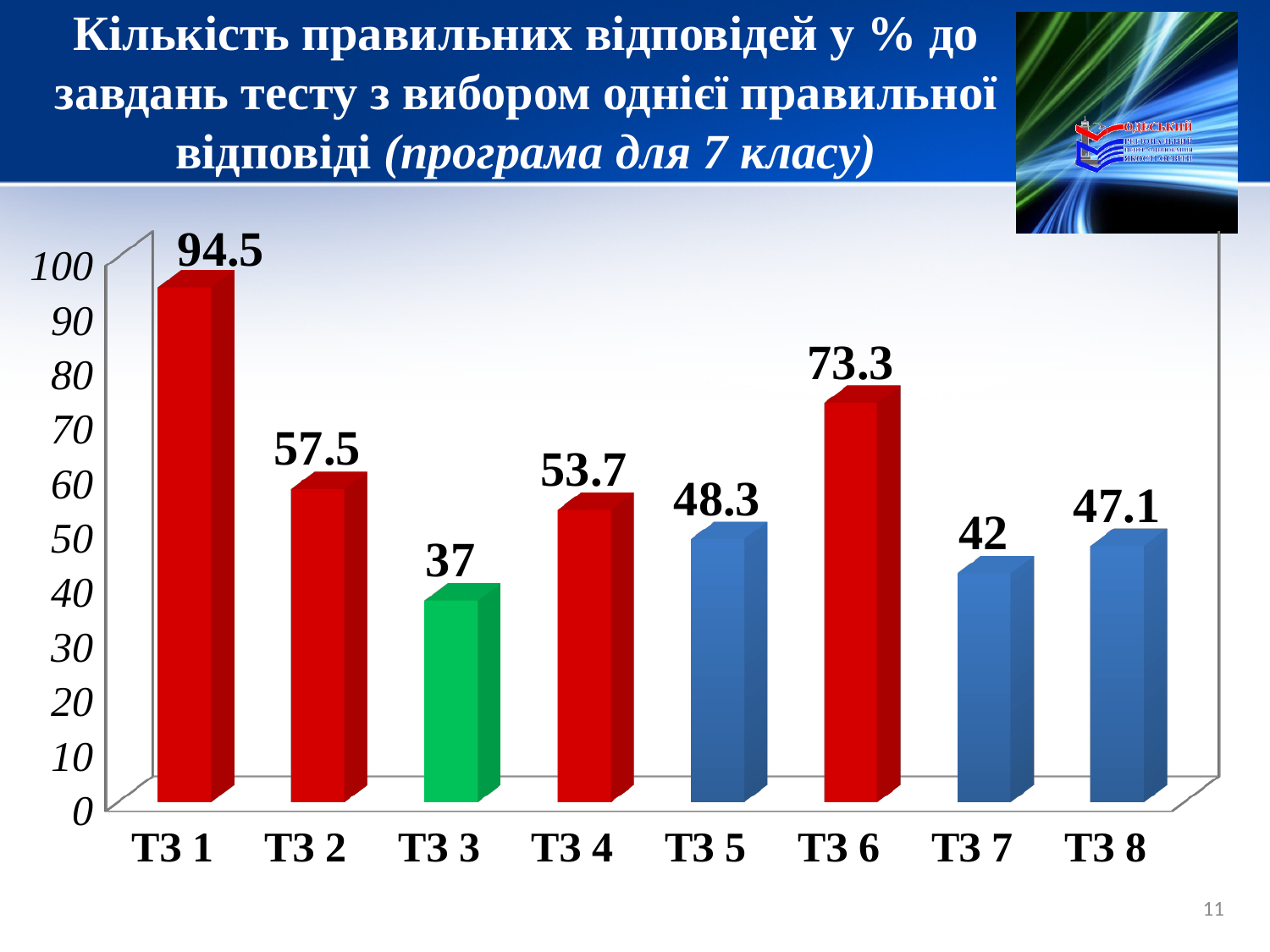
What kind of chart is shown on the slide? bar chart Which category has the highest value? ТЗ 1 How many categories are shown on the x axis? 8 What is the difference between the values for ТЗ 2 and ТЗ 3? 20.5 Which category has the lowest value? ТЗ 3 What is the difference between the values for ТЗ 1 and ТЗ 6? 21.2 What is the value for ТЗ 6? 73.3 What is the value for ТЗ 1? 94.5 What is the value for ТЗ 7? 42 Which is larger, the value for ТЗ 4 or the value for ТЗ 5? ТЗ 4 What colour is the bar for ТЗ 3? green Is the value for ТЗ 8 greater or less than 50? less